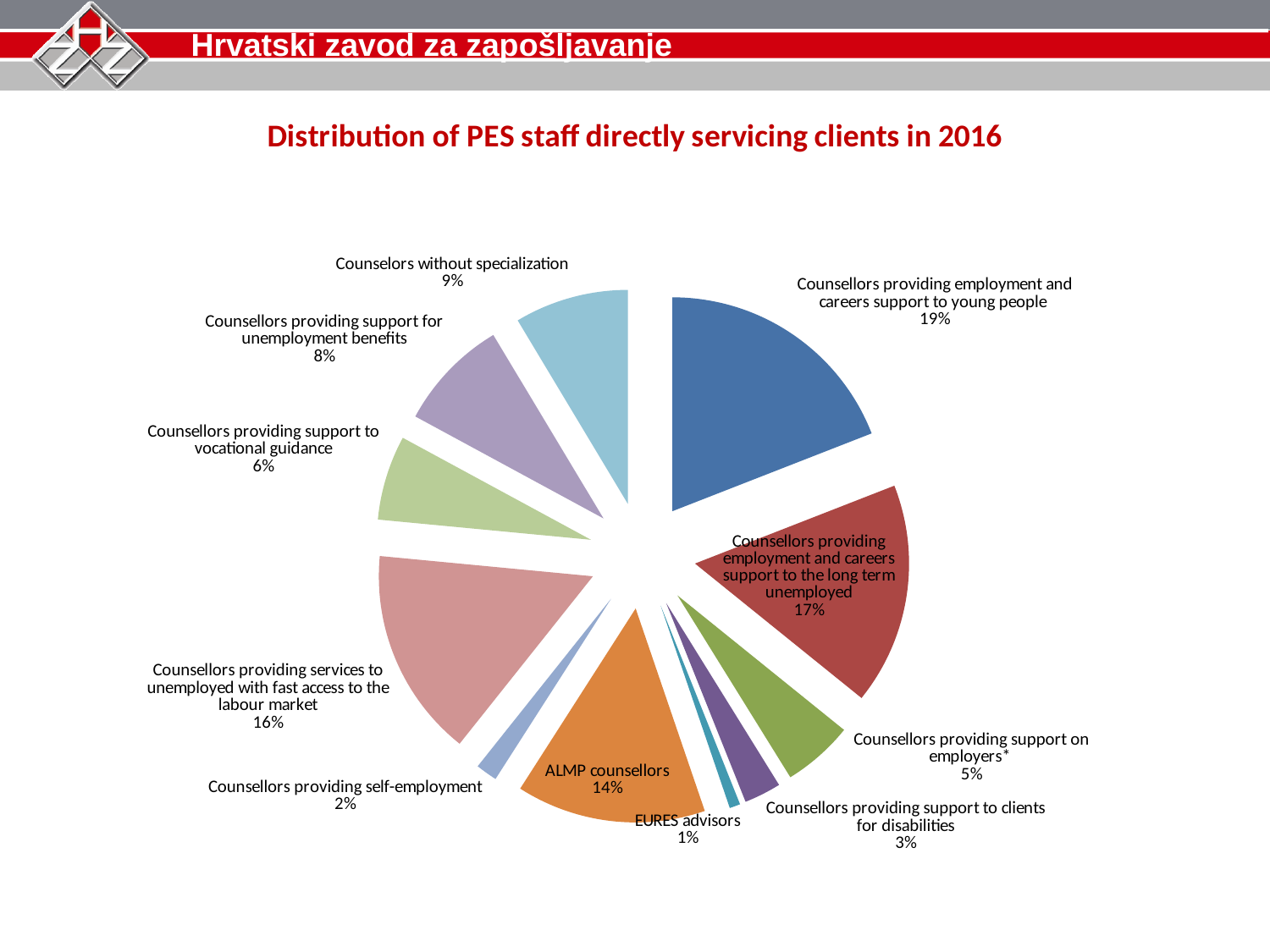
What percentage of staff are ALMP counsellors? 14% What percentage of staff are counsellors providing support to vocational guidance? 6% Which category has the smallest share of the pie? EURES advisors What share of PES staff are counsellors providing employment and careers support to young people? 19% Which category has the largest share of the pie? Counsellors providing employment and careers support to young people What kind of chart is shown on the slide? Pie chart How many categories (slices) does the pie chart have? 11 What is the difference in percentage points between counsellors providing services to unemployed with fast access to the labour market and counsellors providing support for unemployment benefits? 8 Which is larger: the share for counsellors providing support on employers or the share for counsellors providing support to clients for disabilities? Counsellors providing support on employers What is the combined share of counsellors providing employment and careers support to young people and counsellors providing employment and careers support to the long term unemployed? 36% What share is shown for EURES advisors? 1% What is the title of the chart? Distribution of PES staff directly servicing clients in 2016